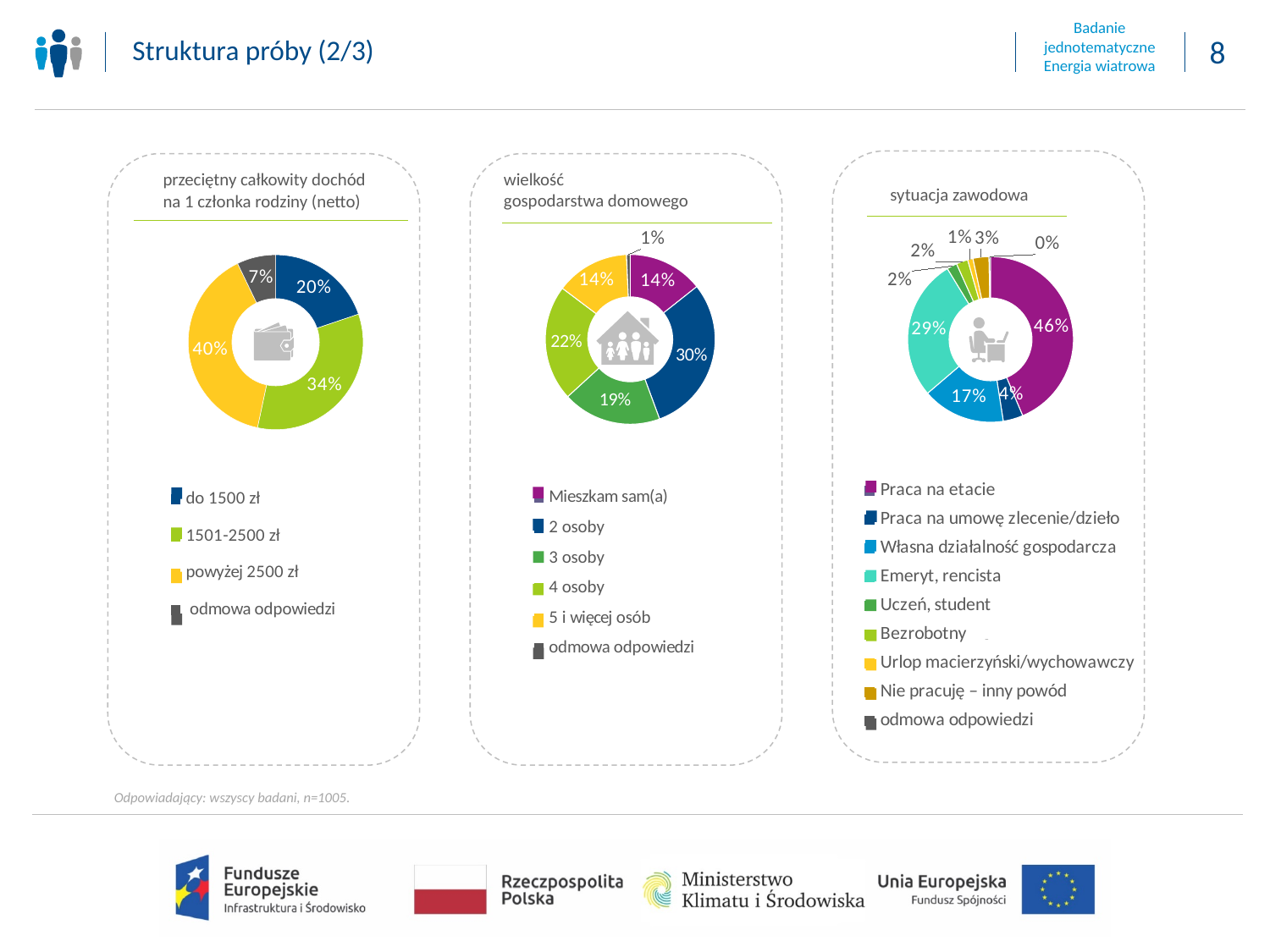
What type of chart is used for 'sytuacja zawodowa'? Donut (pie) chart In the chart titled 'wielkość gospodarstwa domowego', which is larger: '3 osoby' or '4 osoby'? 4 osoby In the chart titled 'wielkość gospodarstwa domowego', what share is '2 osoby'? 30% In the chart titled 'przeciętny całkowity dochód na 1 członka rodziny (netto)', what is the difference between '1501-2500 zł' and 'do 1500 zł'? 14 percentage points How many categories does the legend of the chart titled 'sytuacja zawodowa' list? 9 In the chart titled 'sytuacja zawodowa', what share is 'Emeryt, rencista'? 29% In the chart titled 'wielkość gospodarstwa domowego', which category has the largest share? 2 osoby In the chart titled 'sytuacja zawodowa', what share is 'Praca na etacie'? 46% In the chart titled 'sytuacja zawodowa', what is the difference between 'Praca na etacie' and 'Własna działalność gospodarcza'? 29 percentage points In the chart titled 'przeciętny całkowity dochód na 1 członka rodziny (netto)', what share is 'powyżej 2500 zł'? 40% How many categories does the legend of the chart titled 'wielkość gospodarstwa domowego' list? 6 In the chart titled 'przeciętny całkowity dochód na 1 członka rodziny (netto)', which category has the smallest share? odmowa odpowiedzi